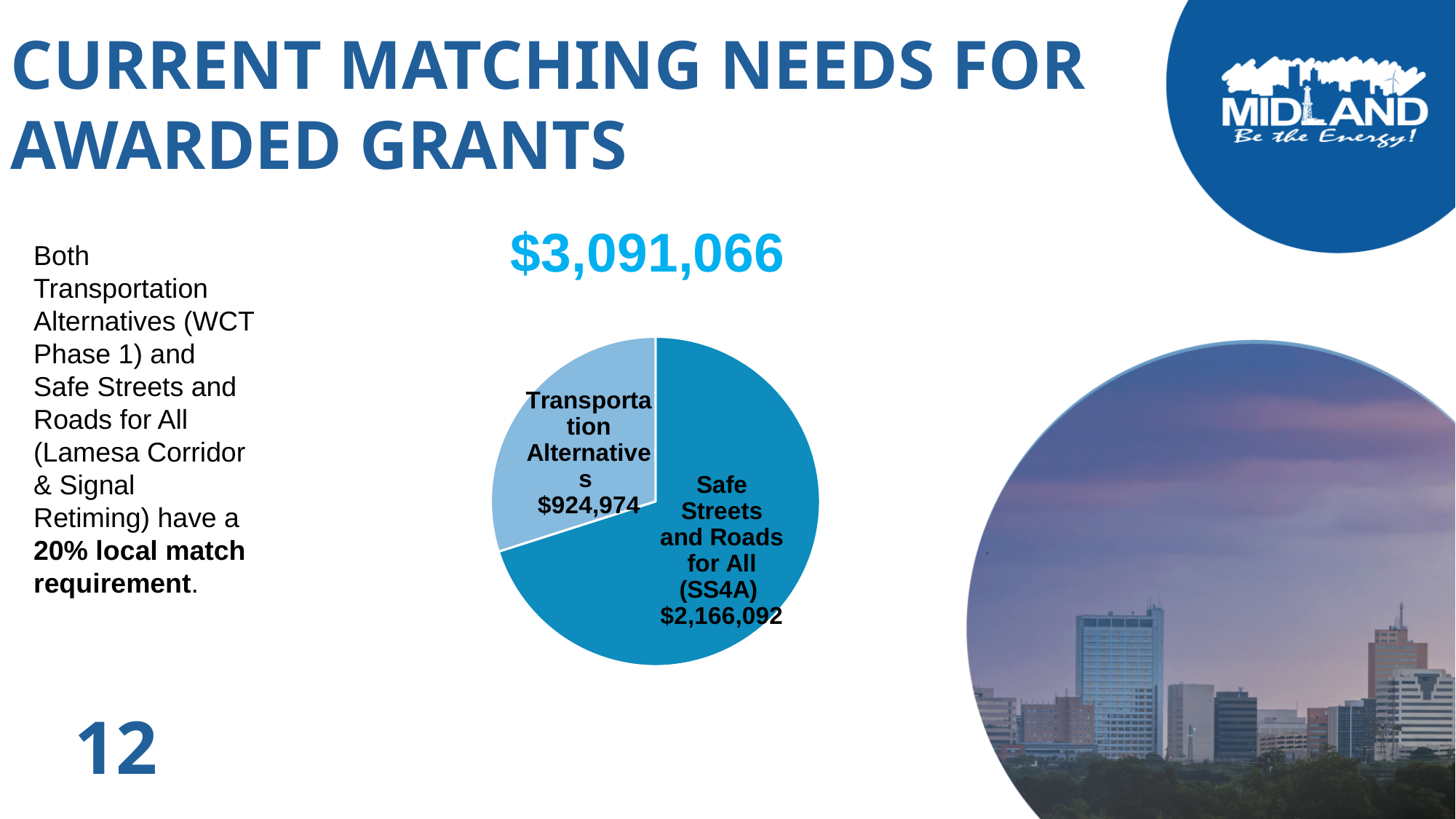
Which slice of the pie chart is shown in the lighter blue colour? Transportation Alternatives Which slice of the pie chart is the largest? Safe Streets and Roads for All (SS4A) What is the total of the two slices in the pie chart, as shown above the chart? $3,091,066 How many slices does the pie chart have? 2 What kind of chart is shown on the slide? Pie chart What is the value of the Transportation Alternatives slice in the pie chart? $924,974 Which slice of the pie chart is the smallest? Transportation Alternatives Which is larger in the pie chart: Transportation Alternatives or Safe Streets and Roads for All (SS4A)? Safe Streets and Roads for All (SS4A) What is the difference between the Safe Streets and Roads for All (SS4A) value and the Transportation Alternatives value in the pie chart? $1,241,118 What is the title of the slide containing the pie chart? Current Matching Needs for Awarded Grants What is the value of the Safe Streets and Roads for All (SS4A) slice in the pie chart? $2,166,092